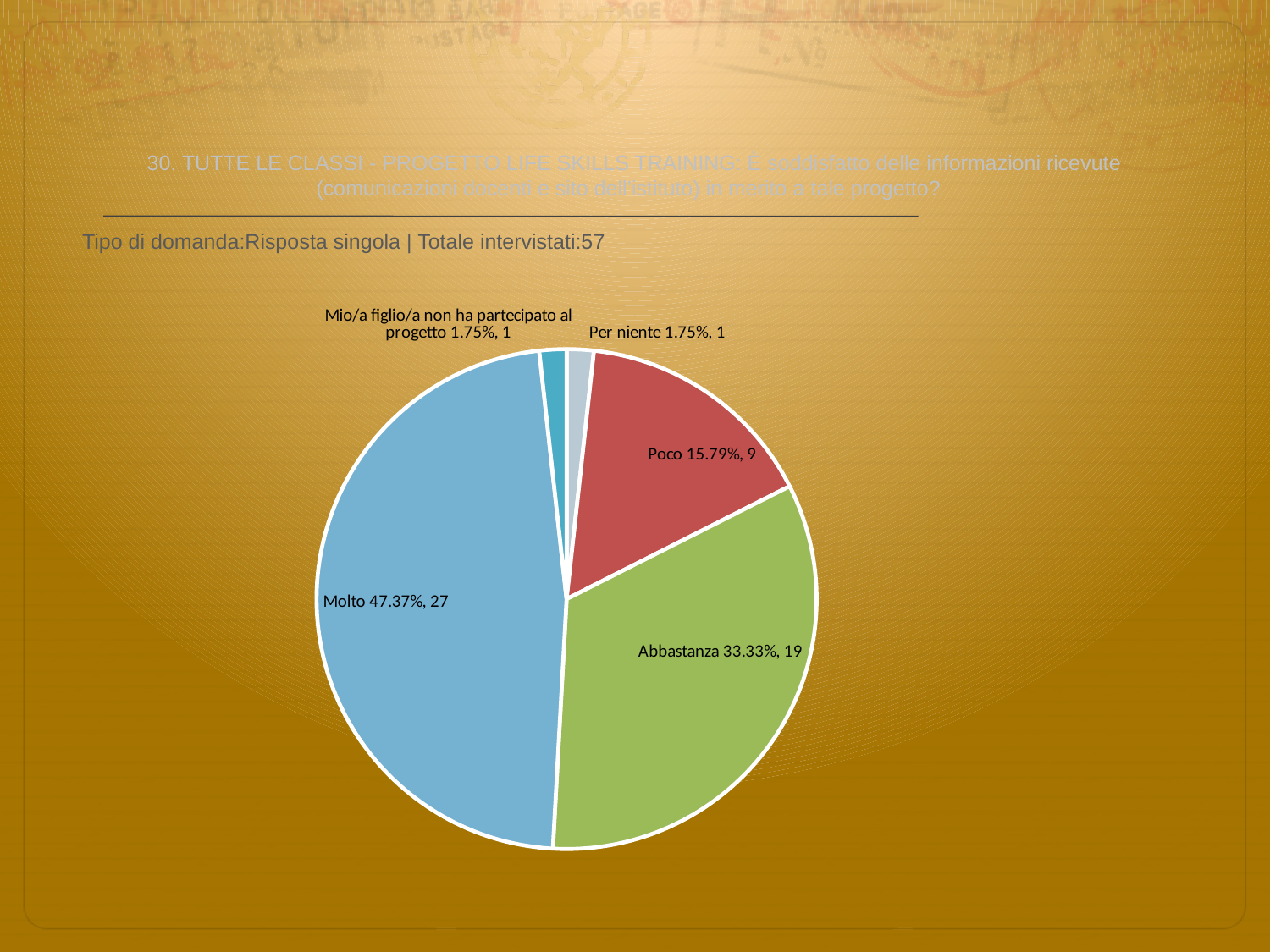
What is the difference in respondent counts between "Molto" and "Abbastanza"? 8 What kind of chart is shown on the slide? pie chart Which is larger, the count for "Abbastanza" or the count for "Poco"? Abbastanza What percentage is shown for "Mio/a figlio/a non ha partecipato al progetto"? 1.75% Which response category has the largest slice of the pie? Molto How many slices does the pie chart have? 5 What percentage of respondents answered "Molto"? 47.37% How many respondents answered "Per niente"? 1 What colour is the "Molto" slice? blue What percentage of respondents answered "Poco"? 15.79% How many respondents answered "Abbastanza"? 19 What is the total number of respondents stated on the slide? 57